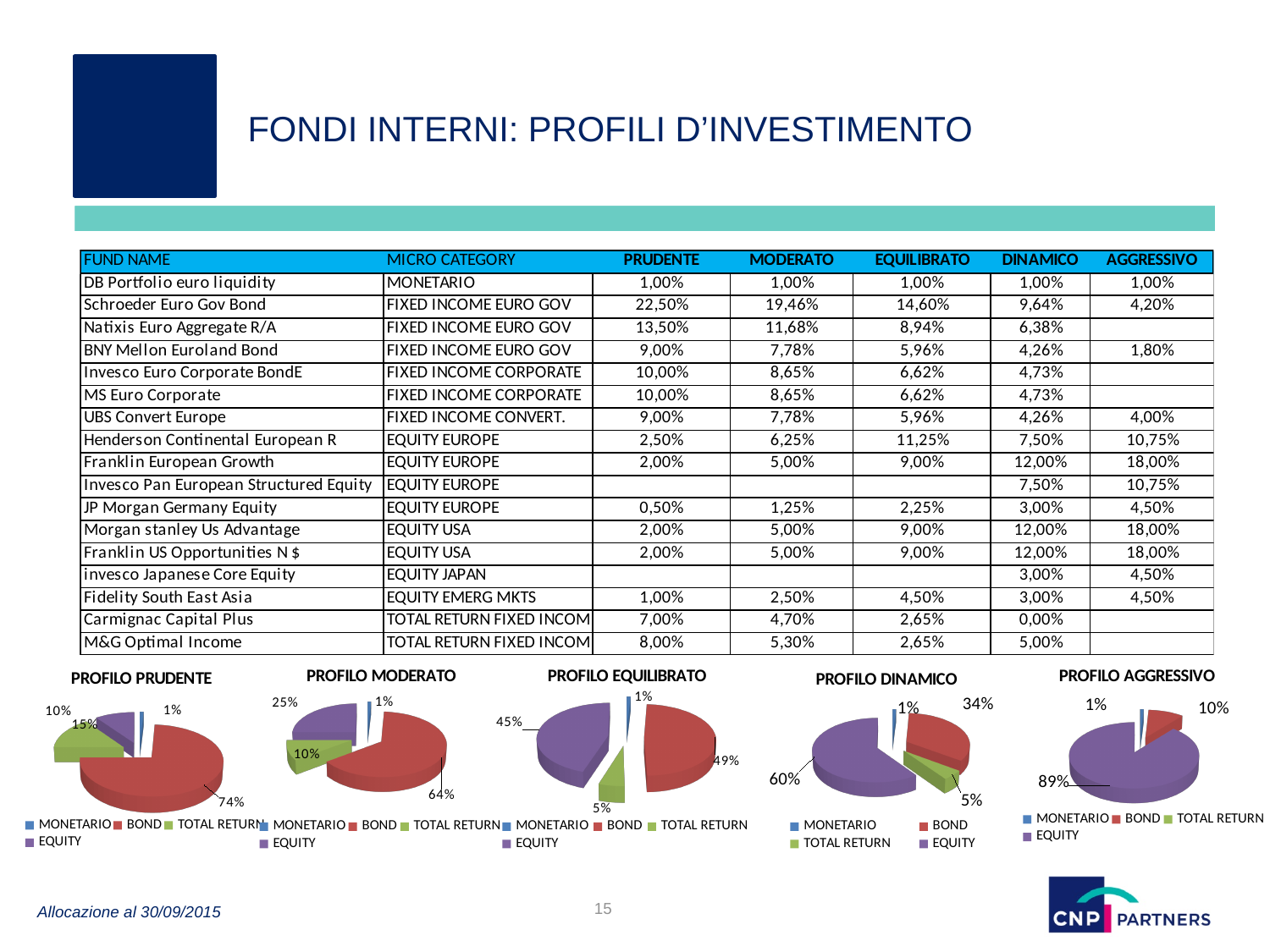
In the PROFILO DINAMICO chart, which is larger, BOND or EQUITY? EQUITY In the PROFILO MODERATO chart, what share does EQUITY have? 25% In the PROFILO PRUDENTE chart, what share does BOND have? 74% In the PROFILO EQUILIBRATO chart, what share does TOTAL RETURN have? 5% How many pie charts are shown on the slide? 5 In the PROFILO MODERATO chart, what is the difference between the BOND share and the EQUITY share? 39% In the PROFILO DINAMICO chart, what share does EQUITY have? 60% In the PROFILO AGGRESSIVO chart, which category has the largest slice? EQUITY In the PROFILO PRUDENTE chart, which category has the largest slice? BOND What kind of chart is PROFILO EQUILIBRATO? Pie chart How many series does the legend of the PROFILO DINAMICO chart list? 4 In the PROFILO AGGRESSIVO chart, what share does EQUITY have? 89%